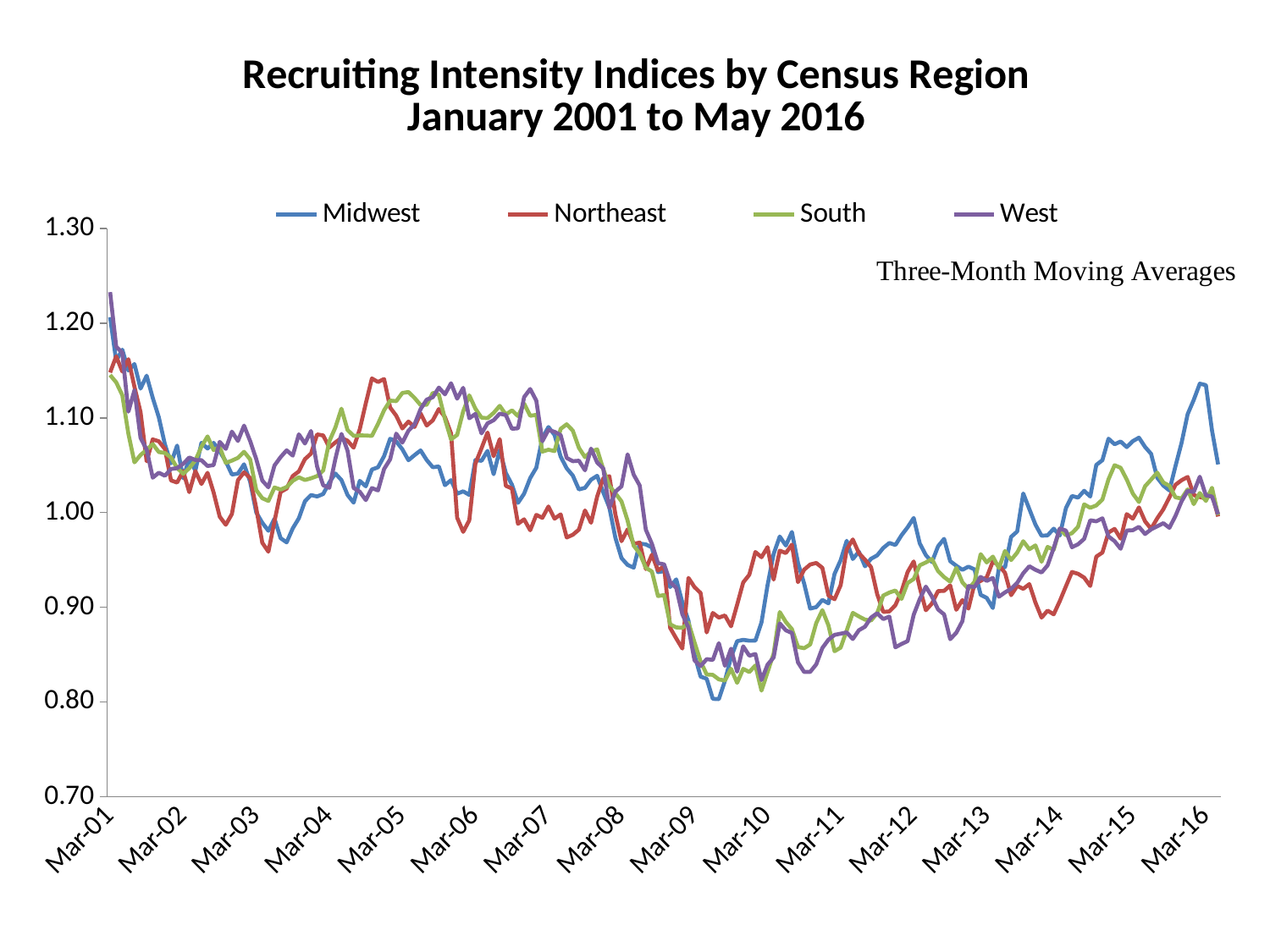
What kind of chart is shown on the slide? line chart How many series does the legend list? 4 Which series is highest at Mar-10? Northeast How many year labels are shown on the x axis? 16 What is the title of the chart? Recruiting Intensity Indices by Census Region January 2001 to May 2016 Which series reaches the lowest point anywhere on the chart? Midwest Is the West value at Mar-01 greater or less than 1.20? greater What are the four series named in the legend? Midwest, Northeast, South, West Is the Midwest value at its peak shortly before Mar-16 greater or less than 1.10? greater Is the Midwest value at its lowest point around late 2009 greater or less than 0.90? less Do the series generally rise or fall between Mar-08 and Mar-09? fall